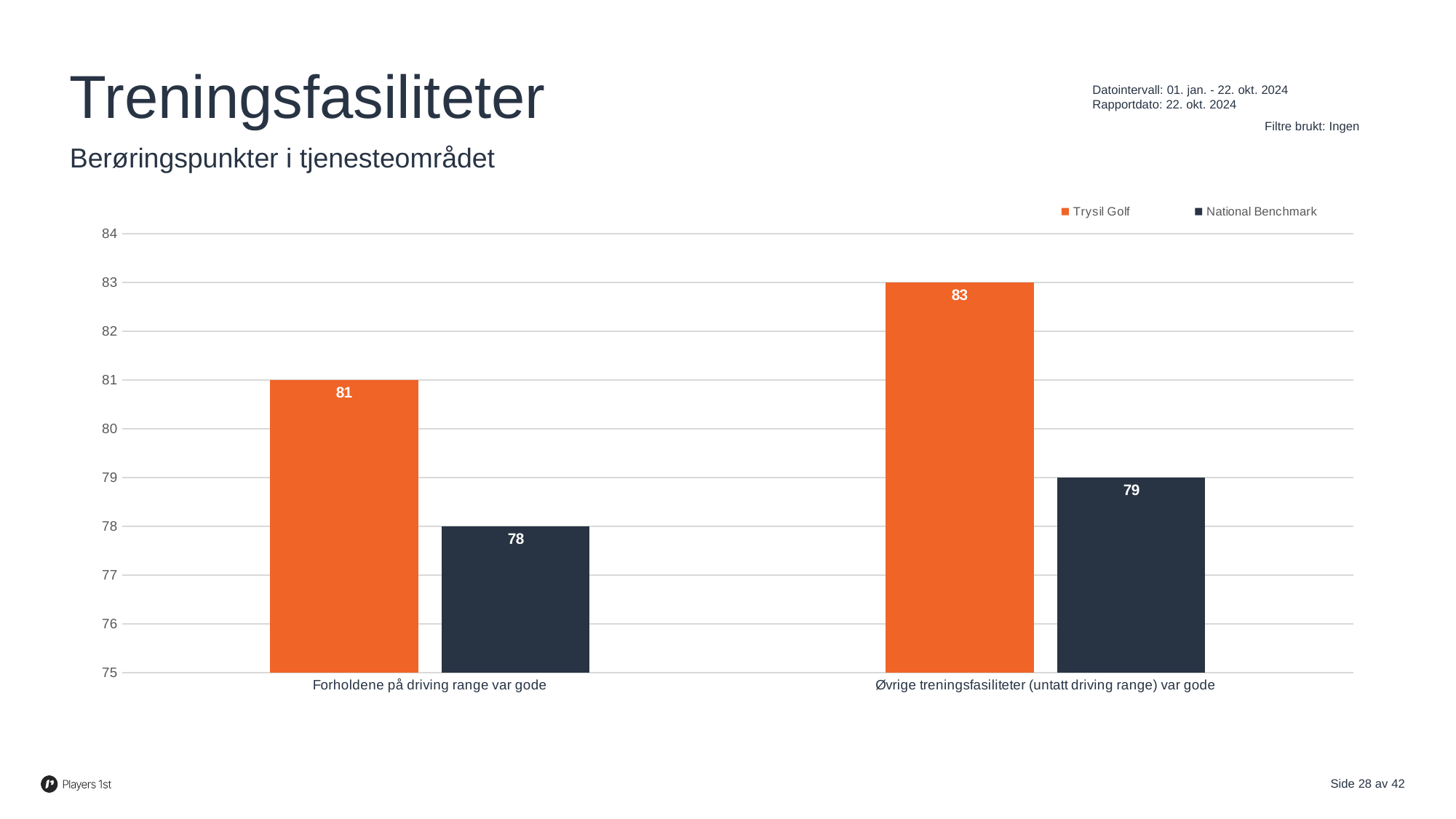
How many categories are shown on the x axis? 2 What is the difference between the Trysil Golf and National Benchmark values for "Øvrige treningsfasiliteter (untatt driving range) var gode"? 4 What is the National Benchmark value for "Øvrige treningsfasiliteter (untatt driving range) var gode"? 79 What is the National Benchmark value for "Forholdene på driving range var gode"? 78 What kind of chart is shown on the slide? Bar chart Which category has the highest Trysil Golf value? Øvrige treningsfasiliteter (untatt driving range) var gode Which category has the lowest National Benchmark value? Forholdene på driving range var gode What is the Trysil Golf value for "Øvrige treningsfasiliteter (untatt driving range) var gode"? 83 Which colour represents Trysil Golf in the legend? Orange For "Forholdene på driving range var gode", which is larger: Trysil Golf or National Benchmark? Trysil Golf How many series does the legend list? 2 What is the Trysil Golf value for "Forholdene på driving range var gode"? 81